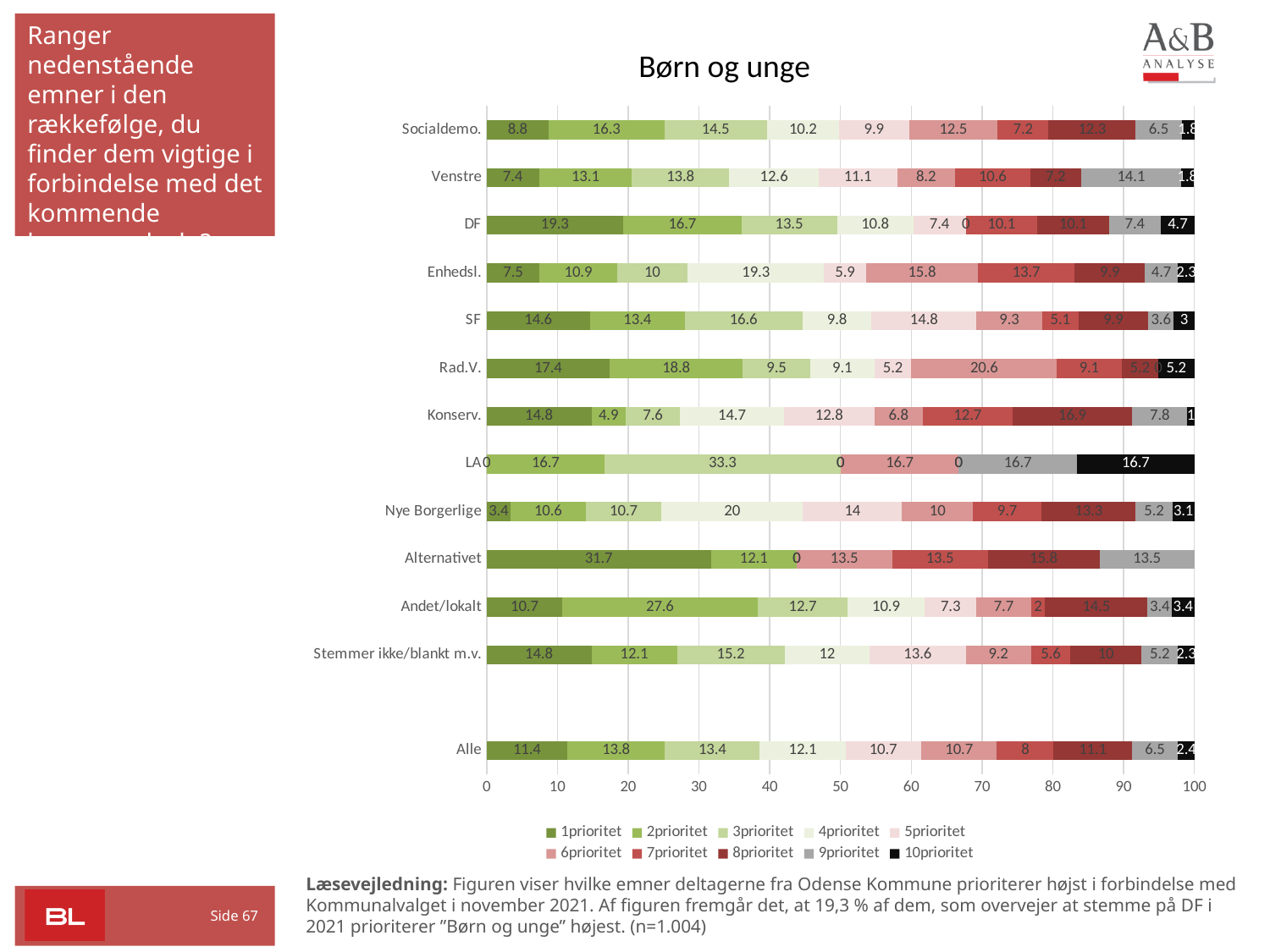
What is the 2prioritet value for Andet/lokalt? 27.6 What is the 1prioritet value for DF? 19.3 What kind of chart is shown? Stacked bar chart What is the 1prioritet value for Alle? 11.4 Which category has the highest 1prioritet value? Alternativet What is the 6prioritet value for Rad.V.? 20.6 What is the title of the chart? Børn og unge What is the difference between the 1prioritet values for DF and Socialdemo.? 10.5 How many categories are shown on the y axis? 13 Which has the larger 1prioritet value, Rad.V. or SF? Rad.V. How many series does the legend list? 10 What is the 1prioritet value for Alternativet? 31.7